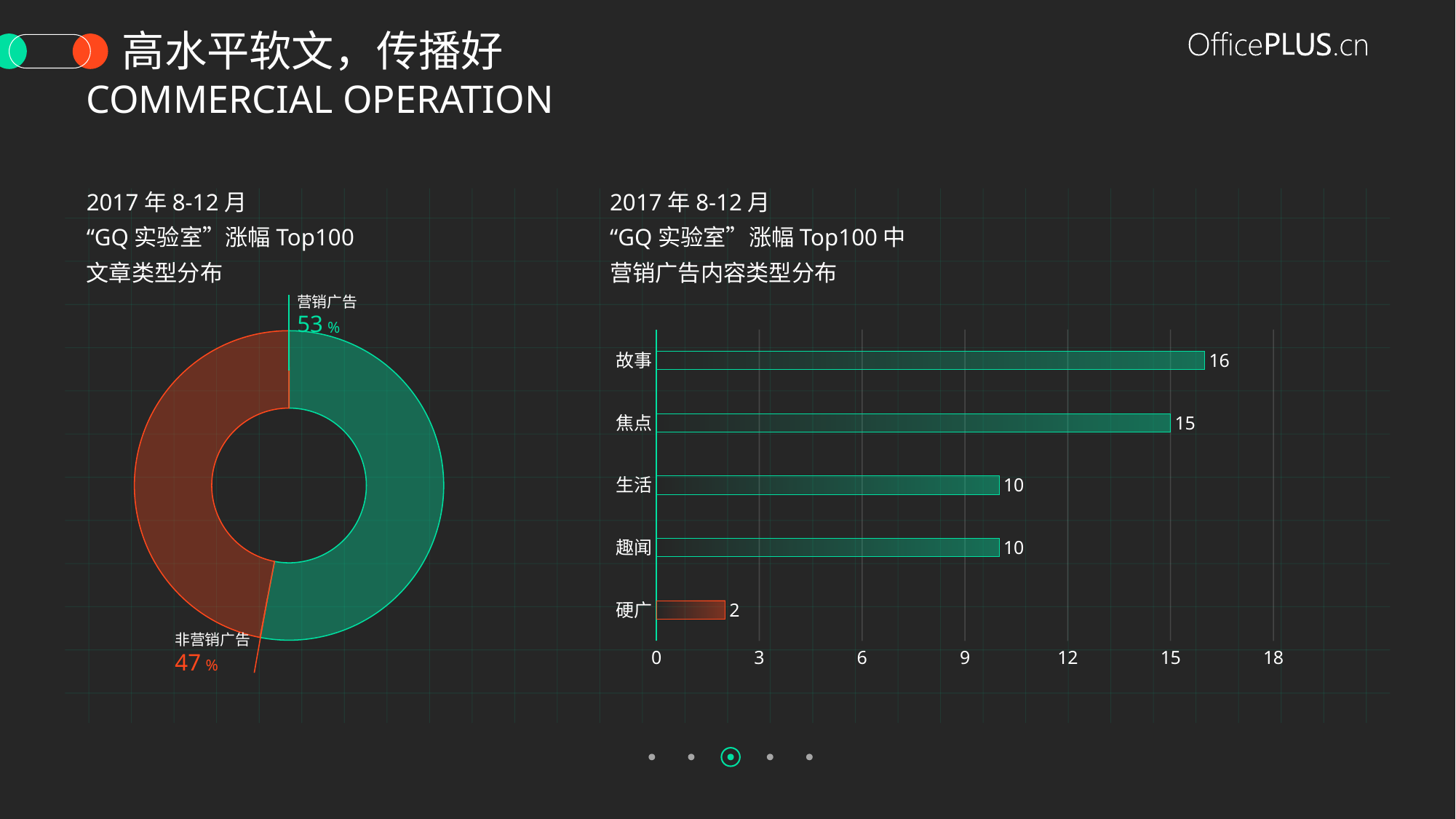
In the right chart (营销广告内容类型分布), what is the difference between the values for 焦点 and 生活? 5 What kind of chart is the left chart (文章类型分布)? Doughnut chart In the right chart (营销广告内容类型分布), what is the value for 故事? 16 In the left chart (文章类型分布), what share does 非营销广告 have? 47% In the right chart (营销广告内容类型分布), which category has the highest value? 故事 In the right chart (营销广告内容类型分布), what is the value for 硬广? 2 In the left chart (文章类型分布), which category has the larger share, 营销广告 or 非营销广告? 营销广告 In the left chart (文章类型分布), what share does 营销广告 have? 53% In the right chart (营销广告内容类型分布), which bar is coloured red-orange instead of green? 硬广 In the right chart (营销广告内容类型分布), which category has the lowest value? 硬广 What kind of chart is the right chart (营销广告内容类型分布)? Bar chart In the right chart (营销广告内容类型分布), how many categories are shown? 5